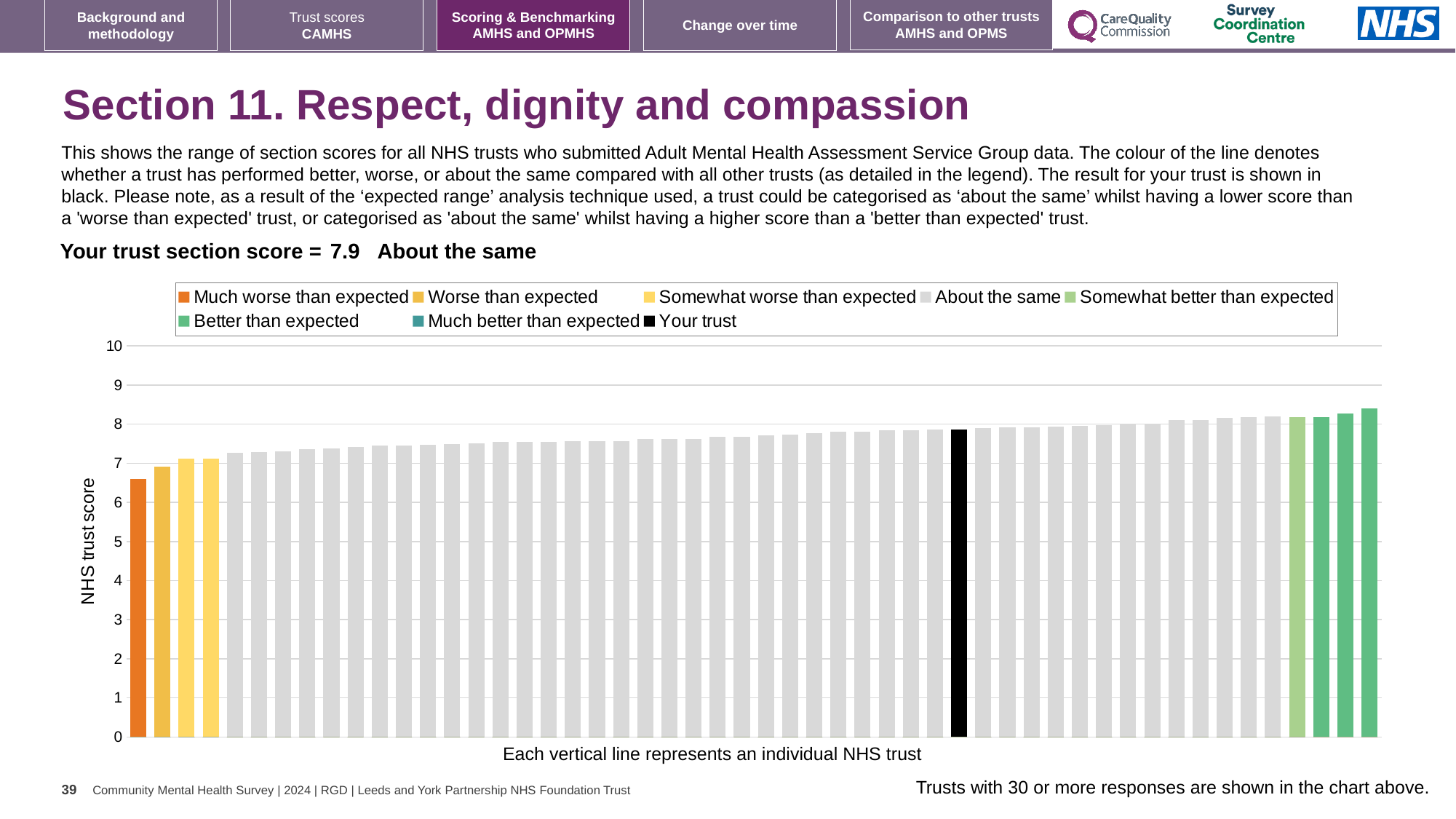
Which legend category does the tallest bar in the chart belong to? Better than expected How many entries does the chart legend list? 8 Which legend category does the lowest bar in the chart belong to? Much worse than expected Do the bar values rise or fall from left to right across the chart? rise What is your trust's section score for Section 11, Respect, dignity and compassion? 7.9 Is your trust's section score greater or less than 7? greater Is the value of the lowest bar in the chart greater or less than 7? less Which category is your trust placed in for Section 11? About the same What is the label on the vertical axis of the chart? NHS trust score Is your trust's section score greater or less than 8? less What kind of chart is shown on the slide? bar chart